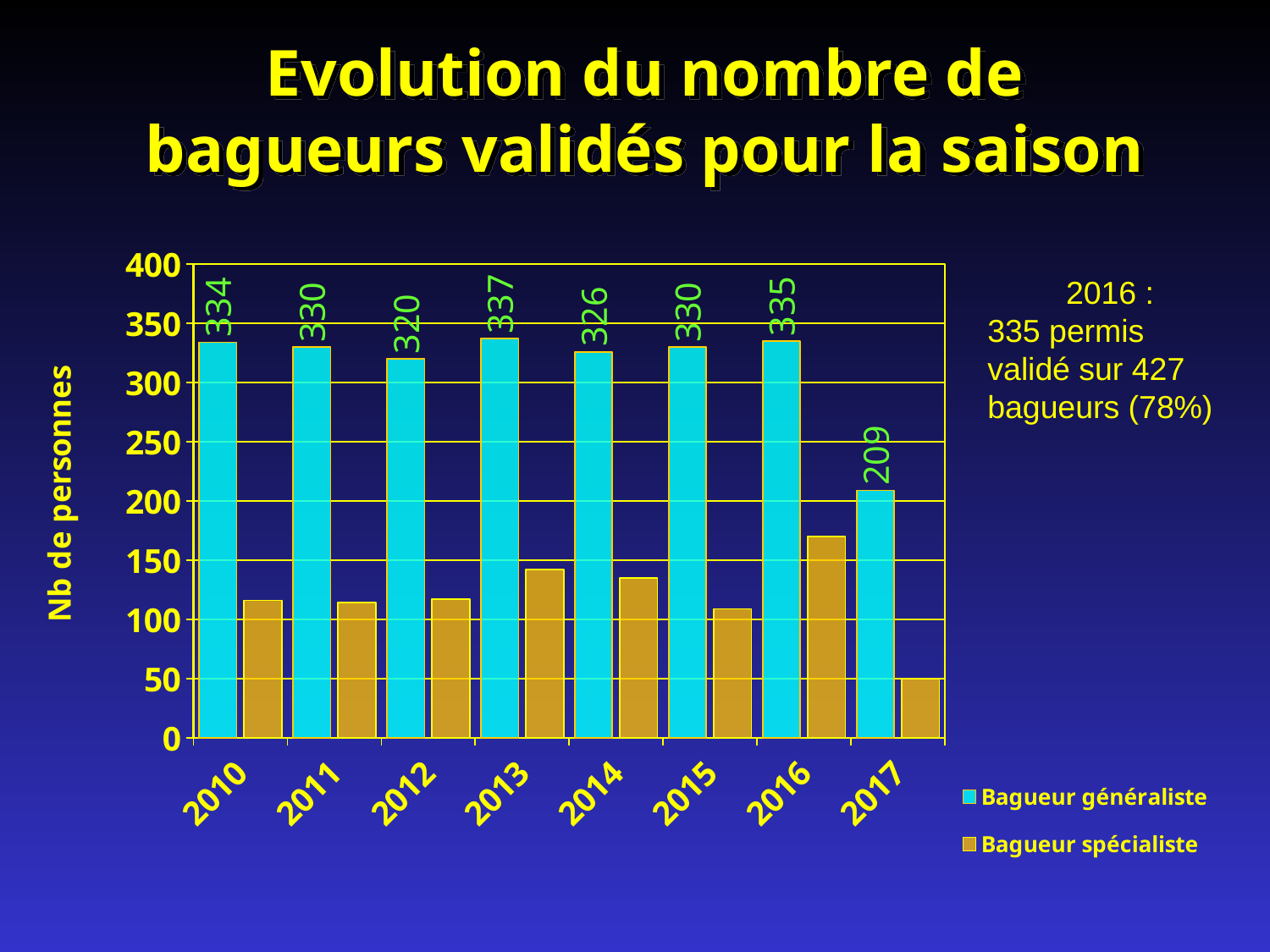
What is the value for Bagueur généraliste in 2012? 320 Which year has the lowest value for Bagueur généraliste? 2017 What is the difference between the Bagueur généraliste values for 2016 and 2017? 126 Is the value for Bagueur spécialiste in 2017 greater or less than 100? less How many years are shown on the x axis? 8 How many series does the legend list? 2 What is the value for Bagueur généraliste in 2017? 209 Is the value for Bagueur spécialiste in 2016 greater or less than 150? greater What is the value for Bagueur généraliste in 2013? 337 Which year has the highest value for Bagueur généraliste? 2013 What type of chart is shown on the slide? bar chart Which is larger, the Bagueur généraliste value for 2010 or for 2011? 2010